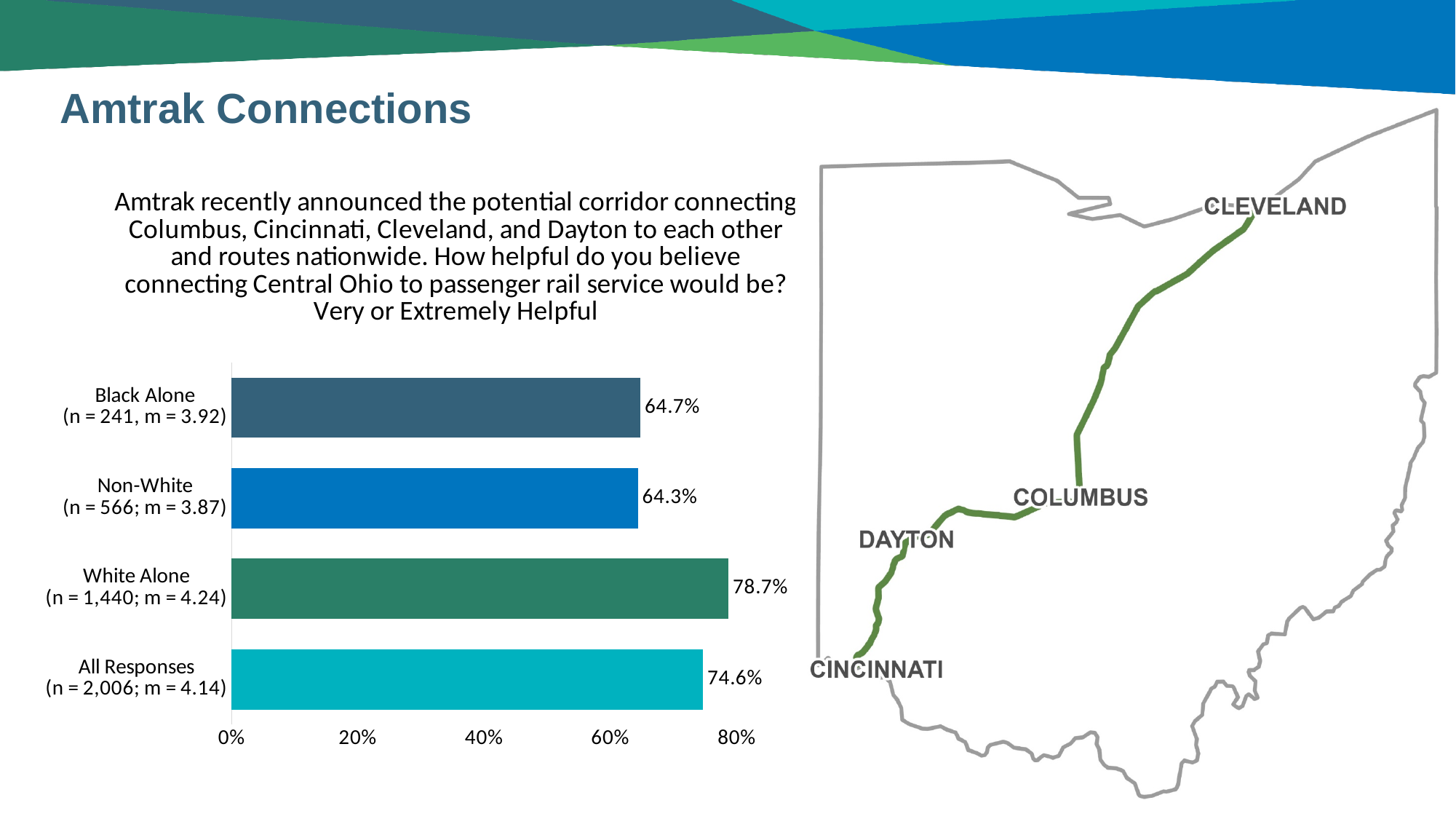
What kind of chart is used to show the survey results? Bar chart What percentage of Black Alone respondents rated connecting Central Ohio to passenger rail service as Very or Extremely Helpful? 64.7% Which group has the highest percentage rating passenger rail as Very or Extremely Helpful? White Alone What is the value shown for All Responses? 74.6% What is the difference in percentage points between White Alone and All Responses? 4.1 How many groups are shown in the bar chart? 4 What is the difference in percentage points between White Alone and Black Alone? 14.0 What is the value shown for the Non-White group? 64.3% Which is larger, the value for White Alone or the value for All Responses? White Alone Which group has the lowest percentage in the chart? Non-White What is the sample size (n) shown for the All Responses group? 2,006 What is the value shown for the White Alone group? 78.7%